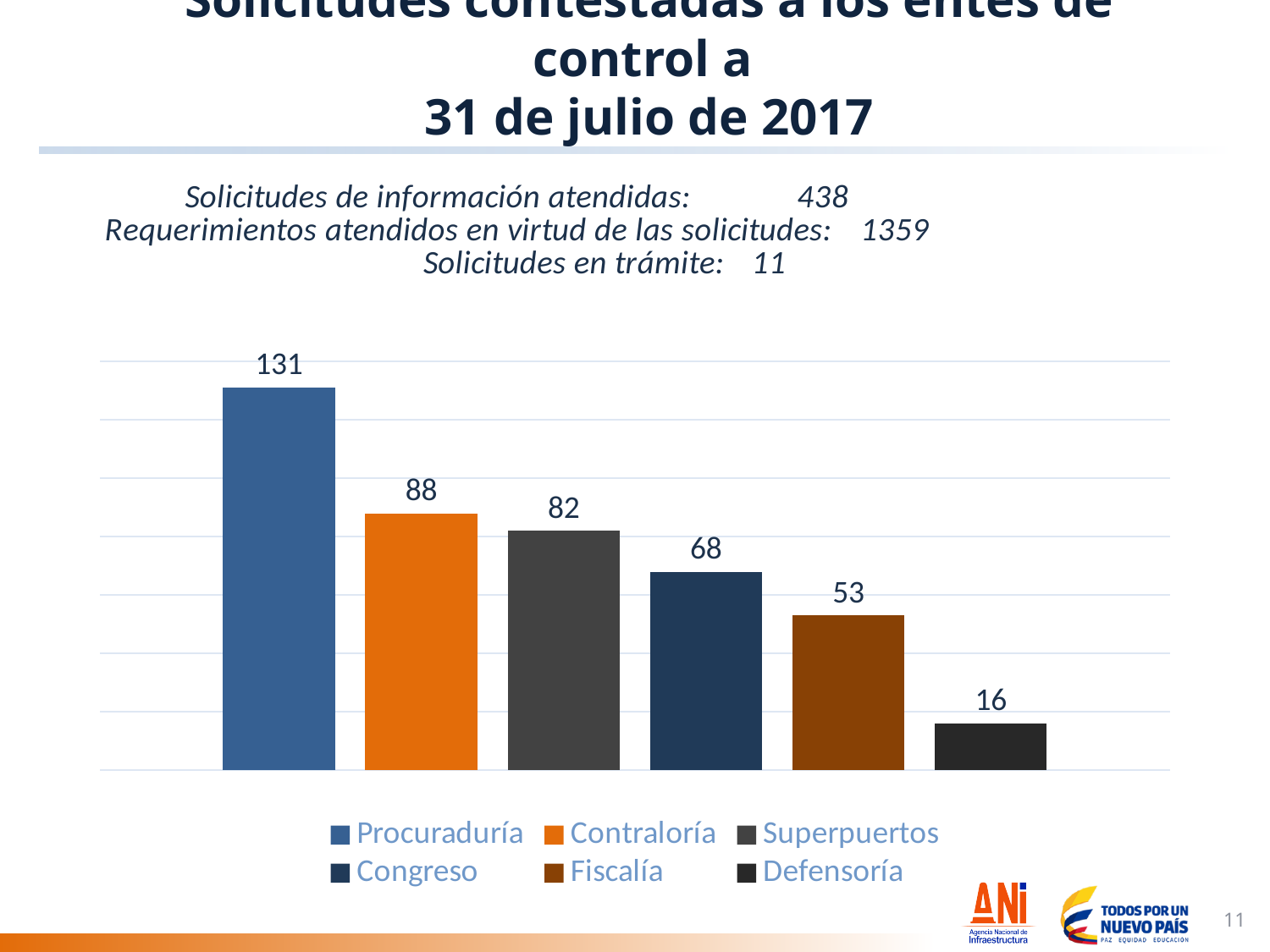
What kind of chart is shown on the slide? Bar chart What is the value for Procuraduría? 131 What is the difference between the values for Procuraduría and Congreso? 63 How many entries does the legend list? 6 Which entity has the highest value in the chart? Procuraduría Which is larger, the value for Contraloría or the value for Superpuertos? Contraloría What is the value for Fiscalía? 53 What is the value for Defensoría? 16 What is the difference between the values for Superpuertos and Fiscalía? 29 How many bars are shown in the chart? 6 What is the value for Contraloría? 88 Which entity has the lowest value in the chart? Defensoría